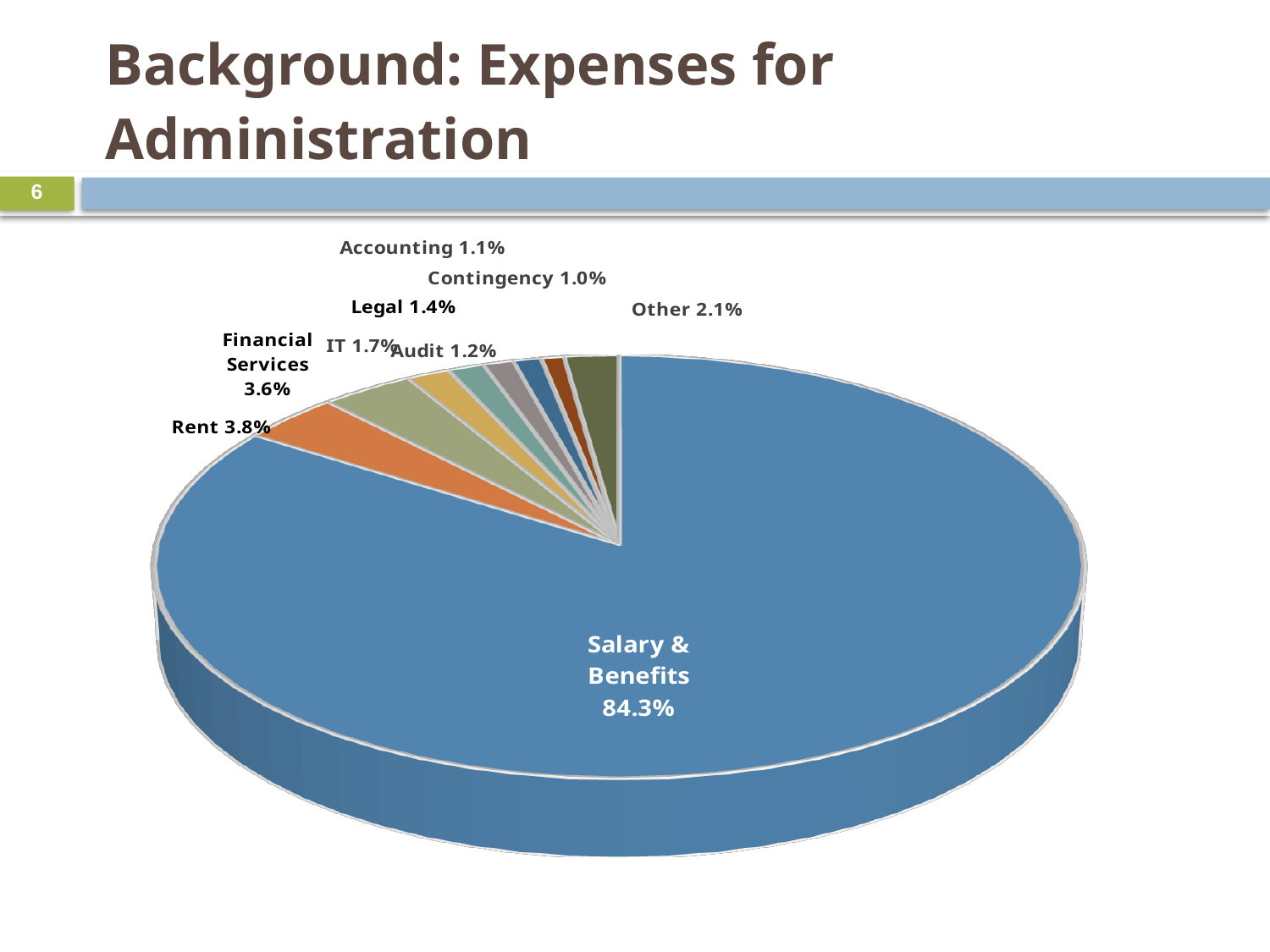
Which category has the largest slice of the pie? Salary & Benefits What share of the pie does Salary & Benefits take? 84.3% Which category has the smallest slice of the pie? Contingency How many slices does the pie chart have? 9 What is the value shown for Rent? 3.8% What is the difference between the Rent share and the Financial Services share? 0.2% What is the title of the slide containing the pie chart? Background: Expenses for Administration What is the value shown for Contingency? 1.0% What is the value shown for IT? 1.7% What kind of chart is shown on the slide? Pie chart What is the value shown for Financial Services? 3.6% Which is larger, the share for Legal or the share for Audit? Legal